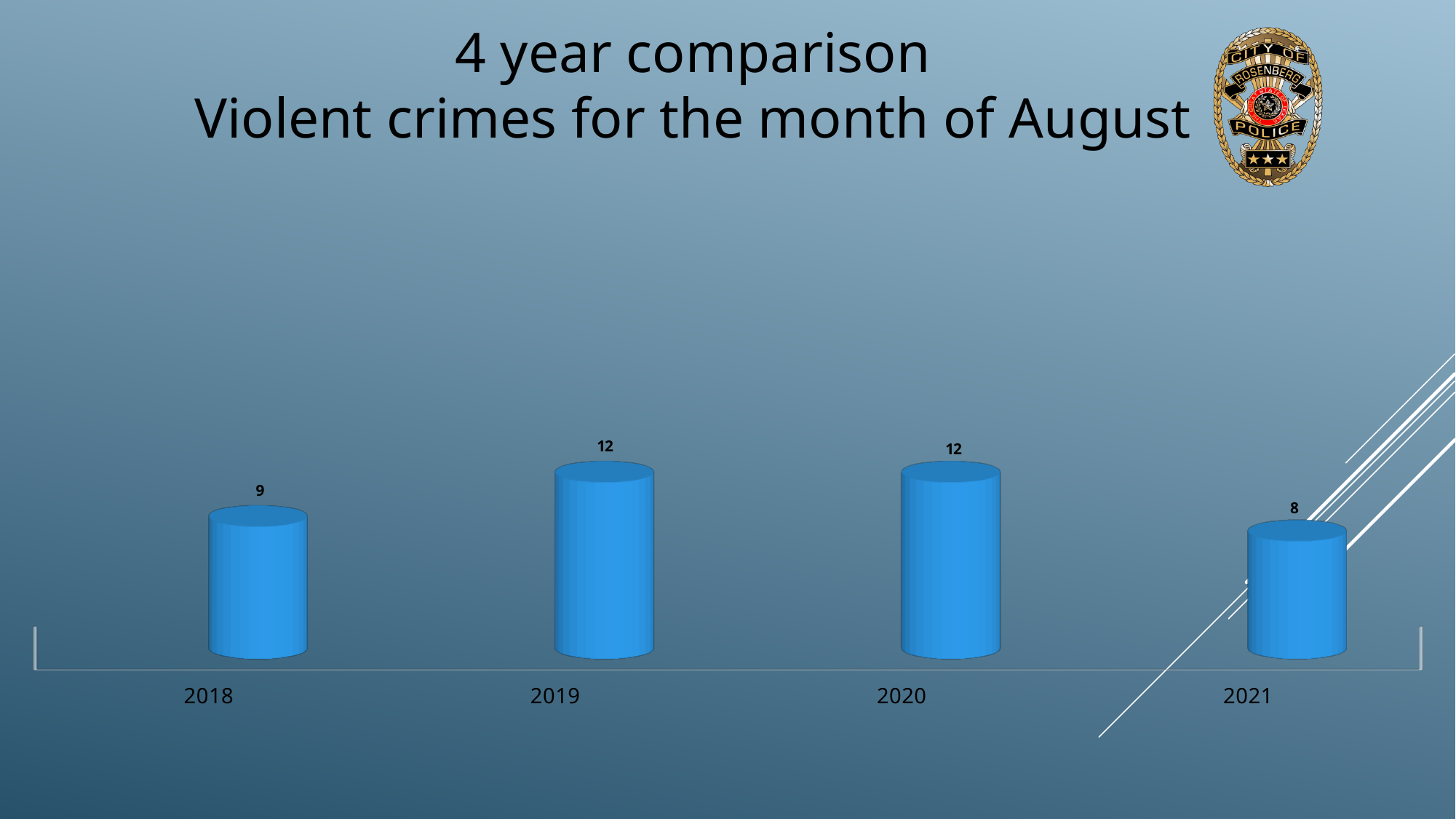
How many years are shown on the chart? 4 What kind of chart is shown on the slide? bar chart Which is larger, the value for 2018 or the value for 2021? 2018 What is the difference between the values for 2019 and 2021? 4 What is the value for 2021? 8 What is the difference between the values for 2018 and 2020? 3 Do the values rise or fall from 2020 to 2021? fall Which year has the lowest value? 2021 What is the title of the slide? 4 year comparison Violent crimes for the month of August What is the value for 2018? 9 What is the value for 2020? 12 What is the value for 2019? 12